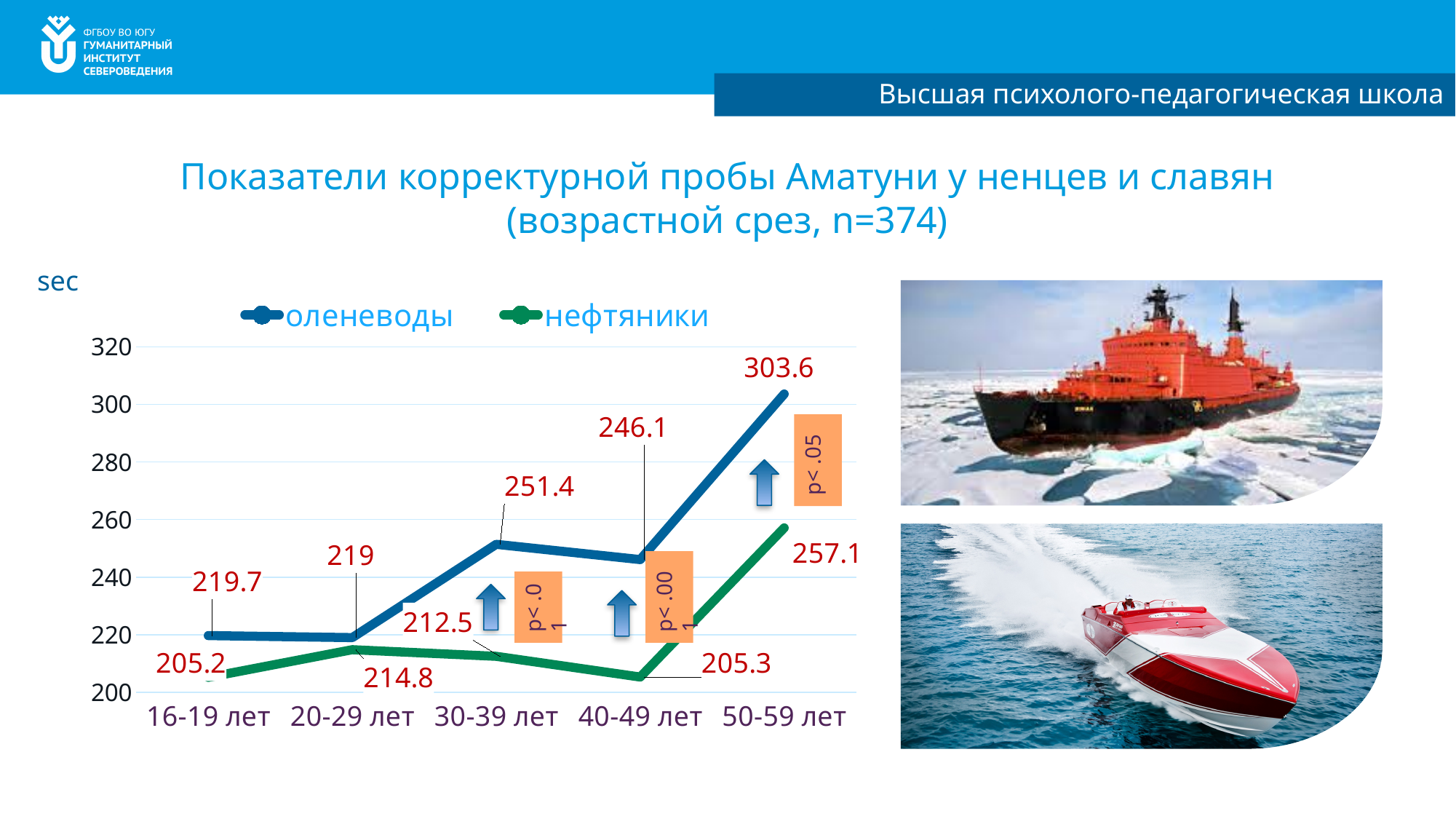
What is the value for нефтяники at 20-29 лет? 214.8 What is the value for оленеводы at 50-59 лет? 303.6 How many age groups are shown on the x axis? 5 What is the value for нефтяники at 40-49 лет? 205.3 What is the value for оленеводы at 30-39 лет? 251.4 What is the difference between оленеводы and нефтяники at 50-59 лет? 46.5 How many series does the legend list? 2 Which is larger at 40-49 лет: оленеводы or нефтяники? оленеводы Which colour is used for the нефтяники series? green Which age group has the highest value for оленеводы? 50-59 лет Which age group has the lowest value for нефтяники? 16-19 лет What kind of chart is shown on the slide? line chart